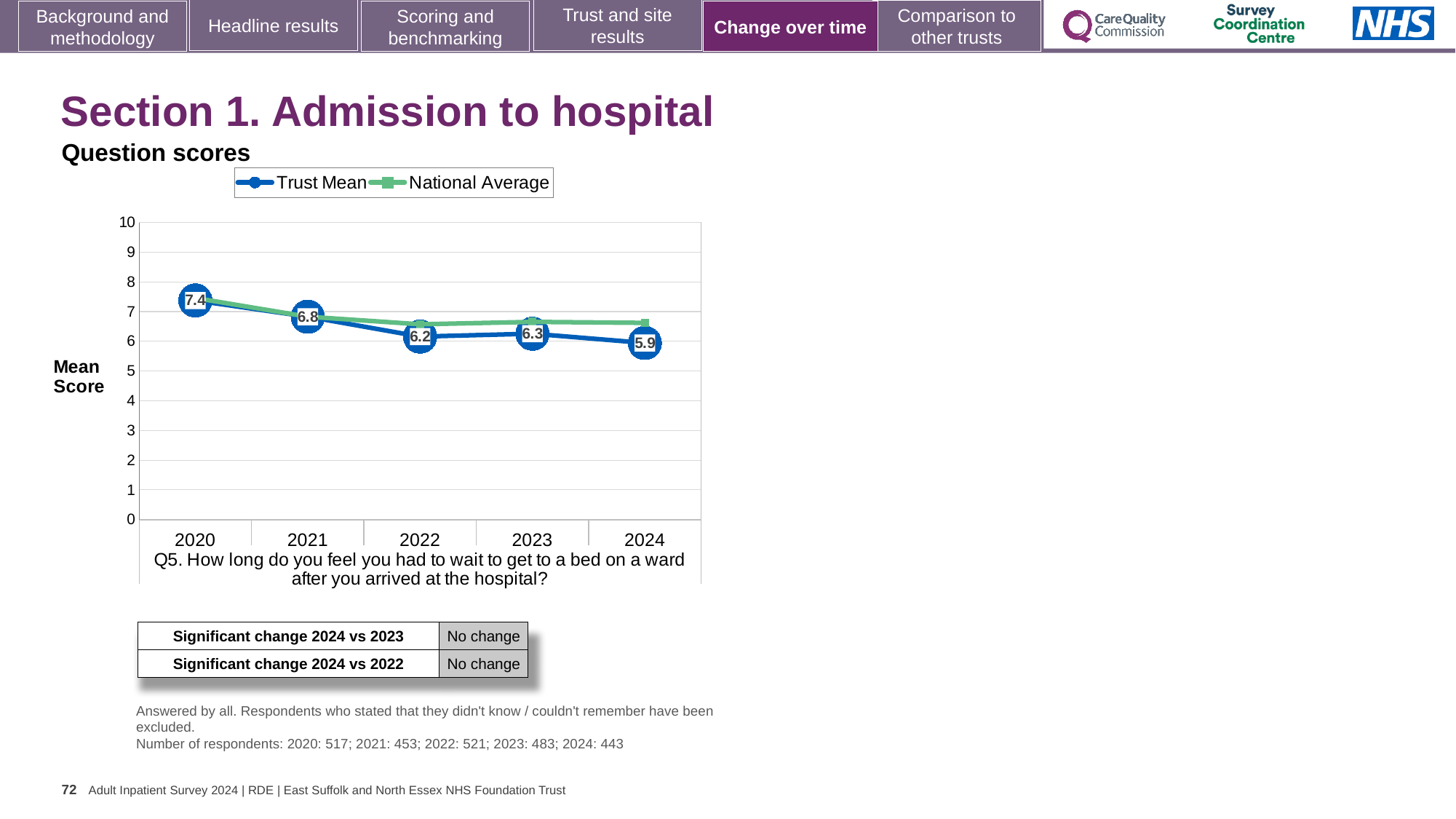
In which year is the Trust Mean score highest? 2020 What is the difference between the Trust Mean scores for 2020 and 2024? 1.5 What kind of chart is shown on the slide? line chart In which year is the Trust Mean score lowest? 2024 Is the National Average value for 2024 greater or less than 6? greater What is the Trust Mean score for 2020? 7.4 How many years are plotted on the x axis? 5 What is the Trust Mean score for 2022? 6.2 How many series does the legend list? 2 What is the Trust Mean score for 2024? 5.9 Which year has the larger Trust Mean score, 2022 or 2023? 2023 Does the Trust Mean score generally rise or fall from 2020 to 2024? fall